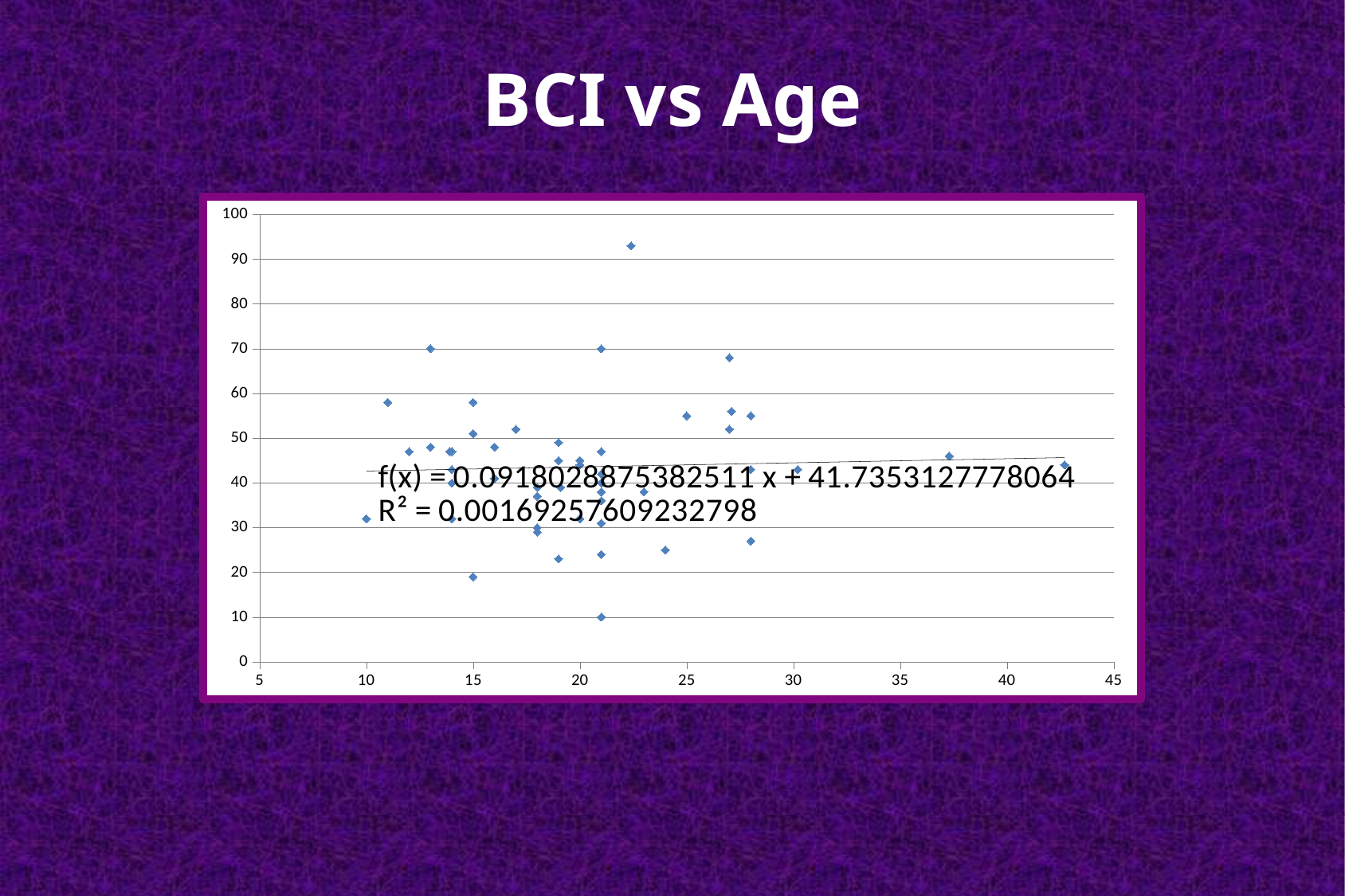
What kind of chart is shown on the slide? scatter chart Is the value of the point near age 37.5 greater or less than 40? greater What trendline equation is printed on the chart? f(x) = 0.0918028875382511 x + 41.7353127778064 What is the title of the chart? BCI vs Age Is the value of the rightmost point (near age 42.5) greater or less than 30? greater Is the value of the leftmost point (near age 10) greater or less than 40? less What R² value is printed on the chart? R² = 0.00169257609232798 Does the trendline rise or fall as age increases along the x axis? rise What is the highest value shown on the y axis? 100